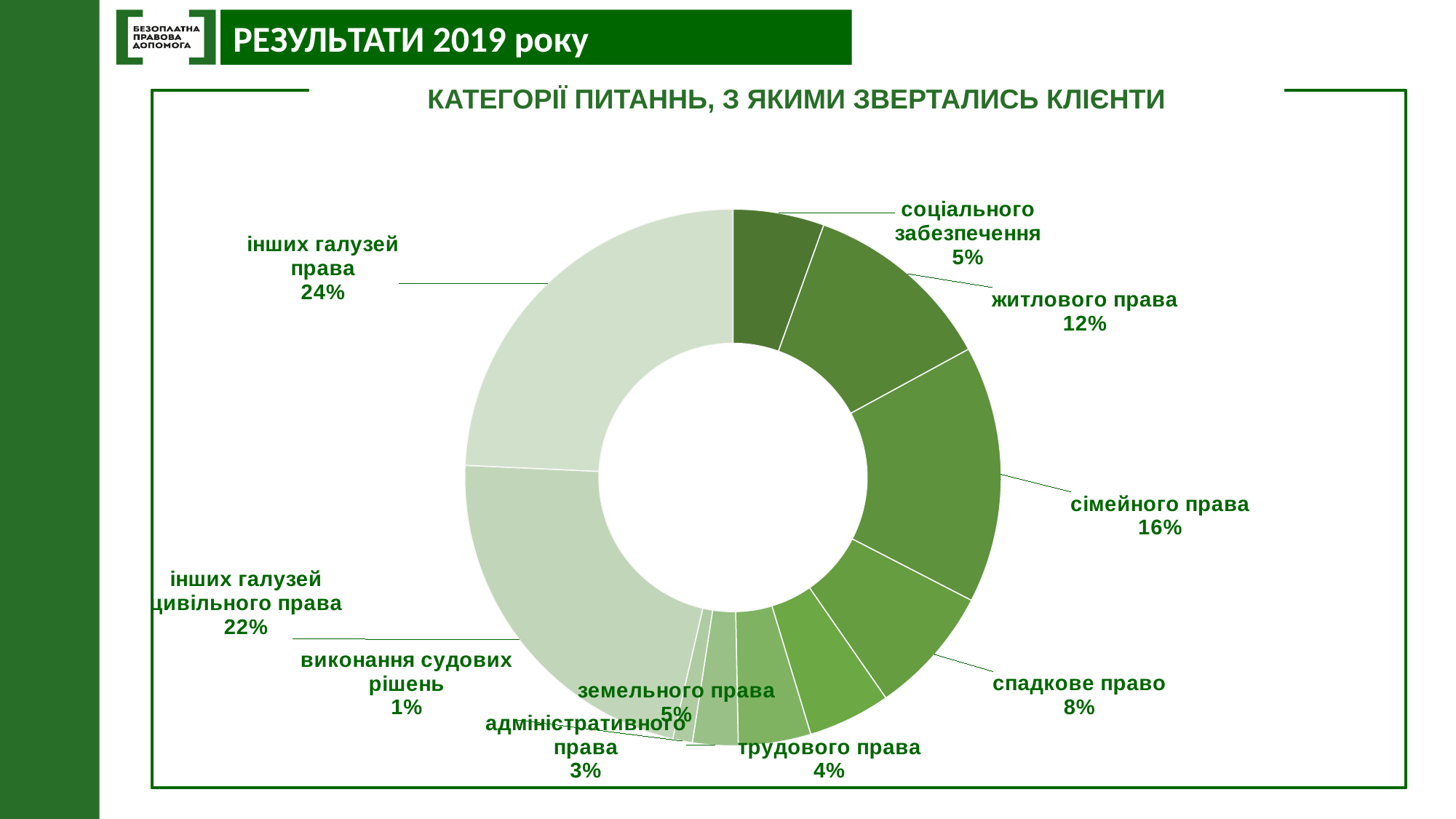
What percentage is shown for "адміністративного права"? 3% What is the title of the chart? КАТЕГОРІЇ ПИТАННЬ, З ЯКИМИ ЗВЕРТАЛИСЬ КЛІЄНТИ What value is printed for "спадкове право"? 8% What share of the chart is labelled "сімейного права"? 16% How many categories are shown in the chart? 10 What is the combined share of "трудового права" and "земельного права"? 9% Which is larger: the share for "сімейного права" or the share for "житлового права"? сімейного права What is the difference in percentage points between "інших галузей права" and "інших галузей цивільного права"? 2 Which category has the largest share in the chart? інших галузей права What kind of chart is shown on the slide? doughnut chart What percentage is shown for "житлового права"? 12% Which category has the smallest share in the chart? виконання судових рішень